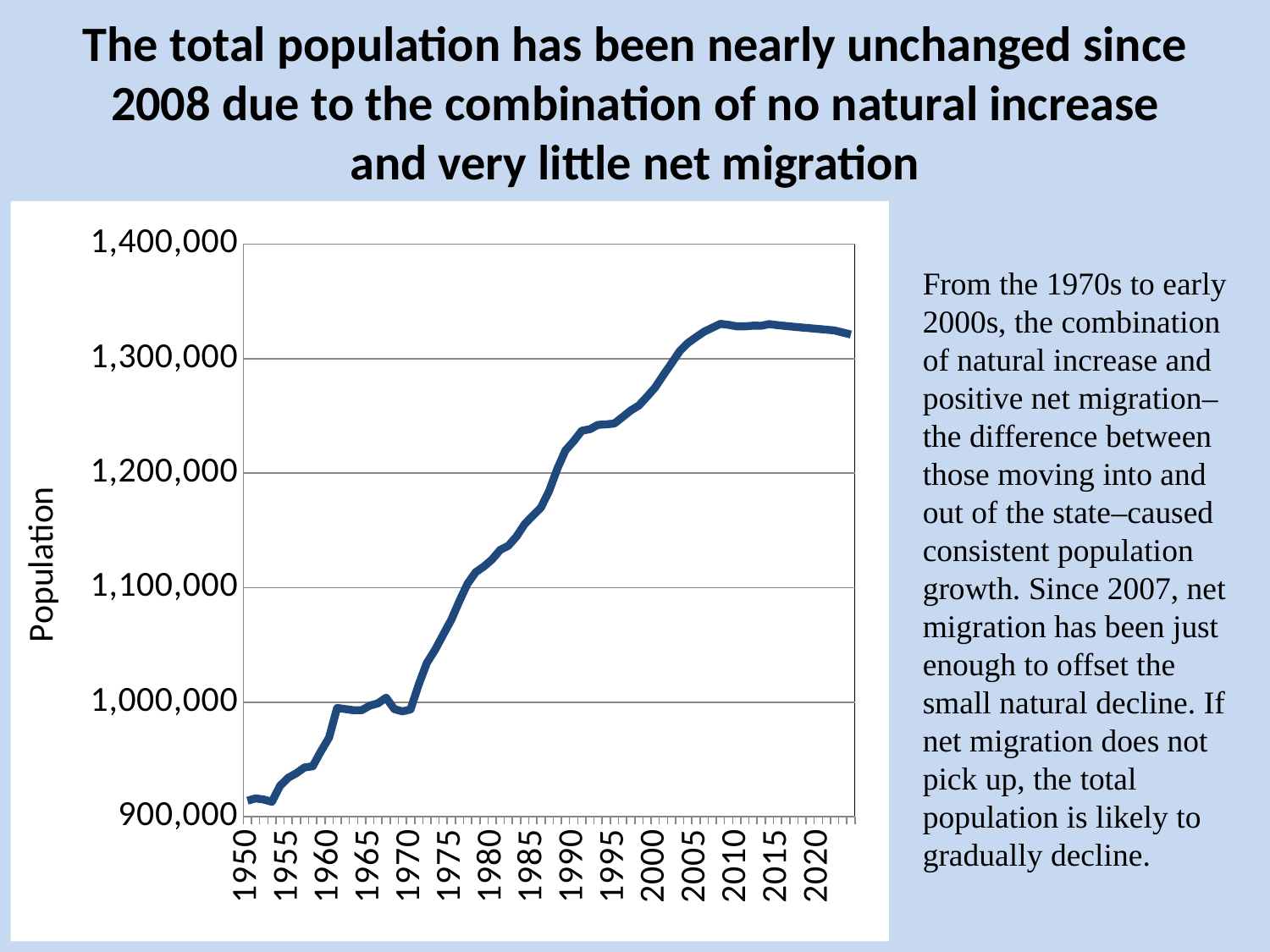
Which year has the larger population value, 1950 or 2020? 2020 Is the population value for 1980 greater or less than 1,100,000? greater Is the population value for 1975 greater or less than 1,000,000? greater Is the population value for 1960 greater or less than 1,000,000? less Does the population generally rise or fall between 1950 and 2005? rise What is the first year shown on the horizontal axis of the chart? 1950 What is the label on the vertical axis of the chart? Population What kind of chart is shown on the slide? line chart